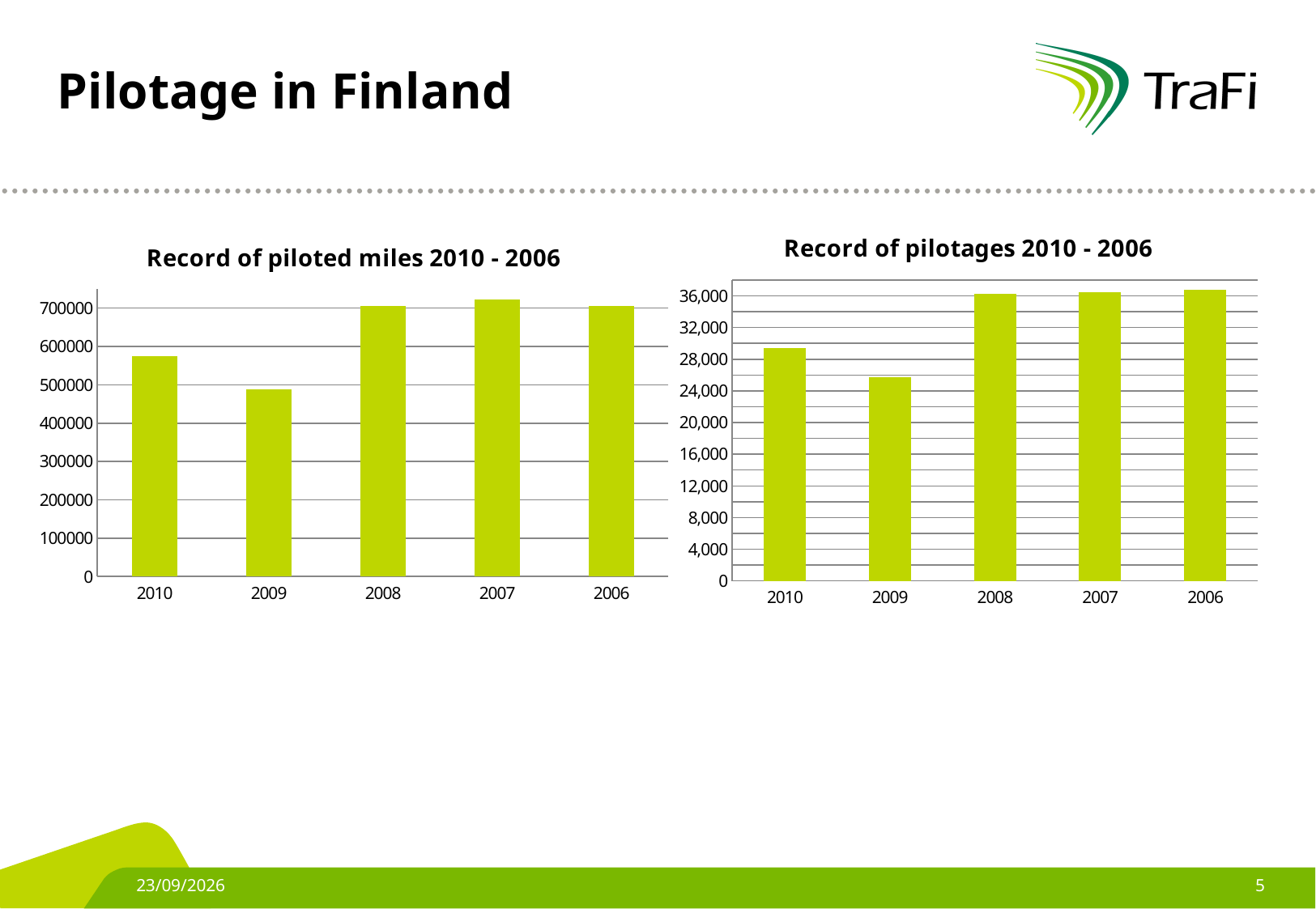
In the 'Record of piloted miles 2010 - 2006' chart, is the value for 2010 greater or less than 500000? greater In the 'Record of pilotages 2010 - 2006' chart, is the value for 2007 greater or less than 32,000? greater In the 'Record of pilotages 2010 - 2006' chart, is the value for 2010 greater or less than 28,000? greater What kind of chart is the 'Record of pilotages 2010 - 2006' chart? bar chart How many years are shown in the 'Record of piloted miles 2010 - 2006' chart? 5 In the 'Record of piloted miles 2010 - 2006' chart, which is larger, the value for 2010 or the value for 2009? 2010 In the 'Record of piloted miles 2010 - 2006' chart, which year has the lowest value? 2009 In the 'Record of pilotages 2010 - 2006' chart, which is larger, the value for 2008 or the value for 2009? 2008 In the 'Record of pilotages 2010 - 2006' chart, which year has the lowest value? 2009